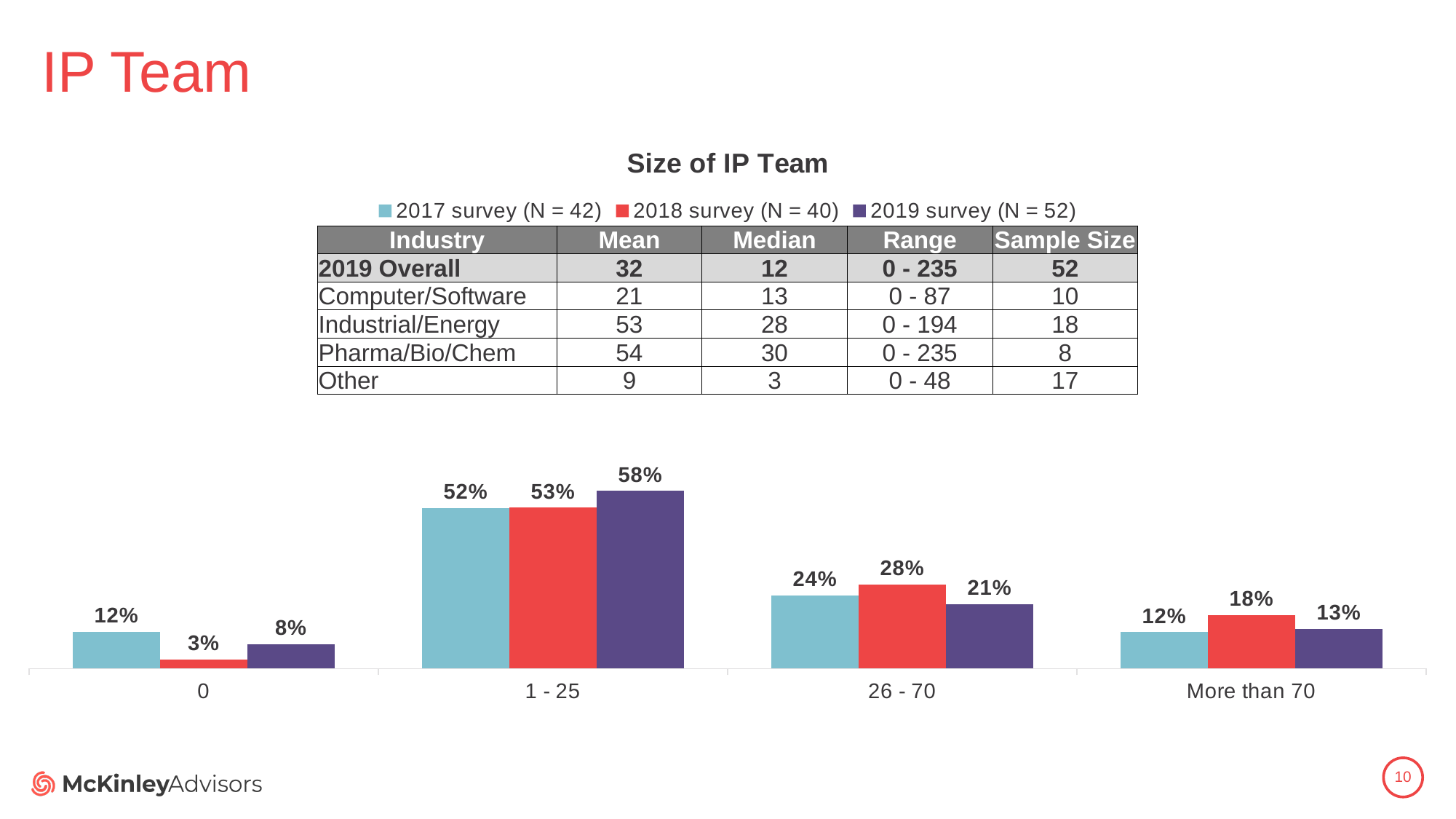
Which is larger in the '26 - 70' category: the 2018 survey value or the 2019 survey value? 2018 survey How many series does the legend list? 3 Which category has the lowest value for the 2018 survey? 0 What kind of chart is shown? Bar chart What is the difference between the 2019 survey and 2017 survey values in the '1 - 25' category? 6% How many categories are shown on the x axis? 4 What is the value for the 2019 survey in the '1 - 25' category? 58% What is the value for the 2017 survey in the '26 - 70' category? 24% Which category has the highest value for the 2019 survey? 1 - 25 What is the value for the 2018 survey in the '0' category? 3% What is the title of the chart? Size of IP Team What is the value for the 2018 survey in the 'More than 70' category? 18%